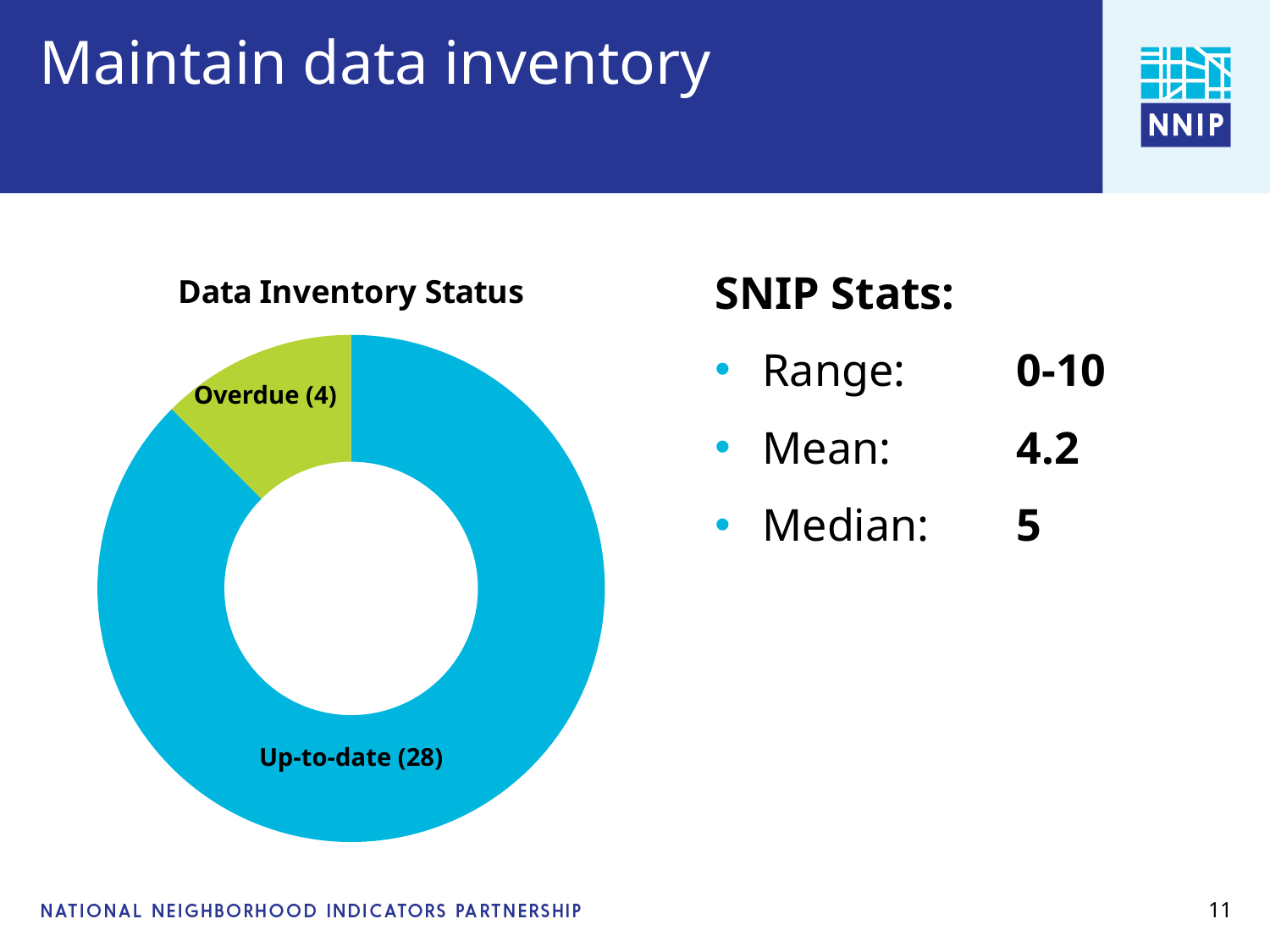
What is the difference between the Up-to-date and Overdue values? 24 What is the value for Overdue? 4 What is the total of all categories in the chart? 32 Which category has the smallest value? Overdue Which category has the largest value? Up-to-date What share of the chart does Overdue represent? 12.5% What is the value for Up-to-date? 28 What colour is the Overdue slice? Green Which is larger, Up-to-date or Overdue? Up-to-date How many categories does the chart show? 2 What kind of chart is shown on the slide? Doughnut chart What is the title of the chart? Data Inventory Status